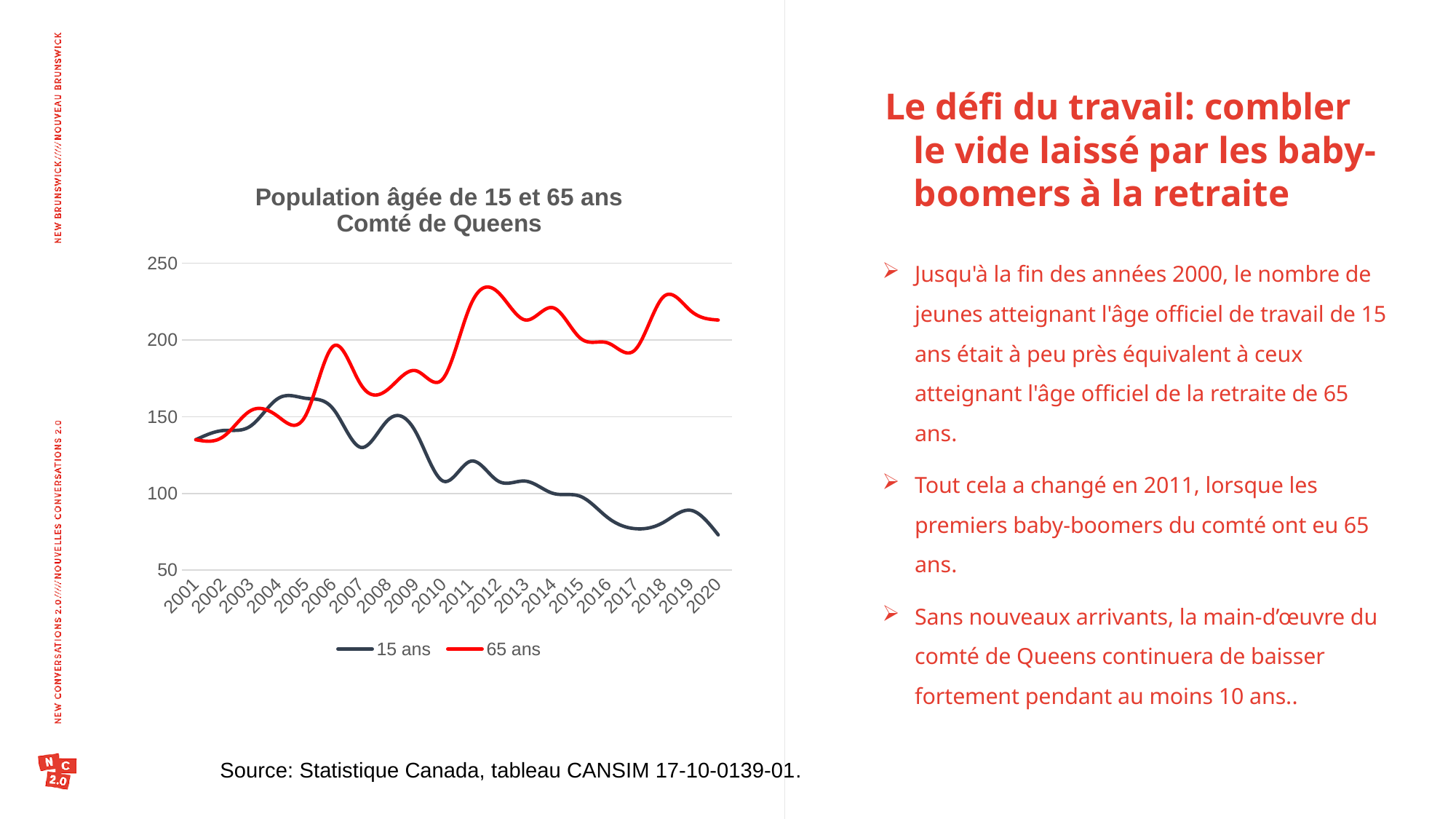
Is the value for 15 ans in 2004 greater or less than 150? greater How many years are shown on the x axis? 20 Is the value for 15 ans in 2020 greater or less than 100? less Does the 65 ans series rise or fall overall from 2001 to 2020? rise Does the 15 ans series rise or fall overall from 2001 to 2020? fall How many series does the legend list? 2 Is the value for 65 ans in 2012 greater or less than 200? greater What kind of chart is shown on the slide? line chart In 2020, which series has the higher value, 15 ans or 65 ans? 65 ans Which series is drawn in red? 65 ans